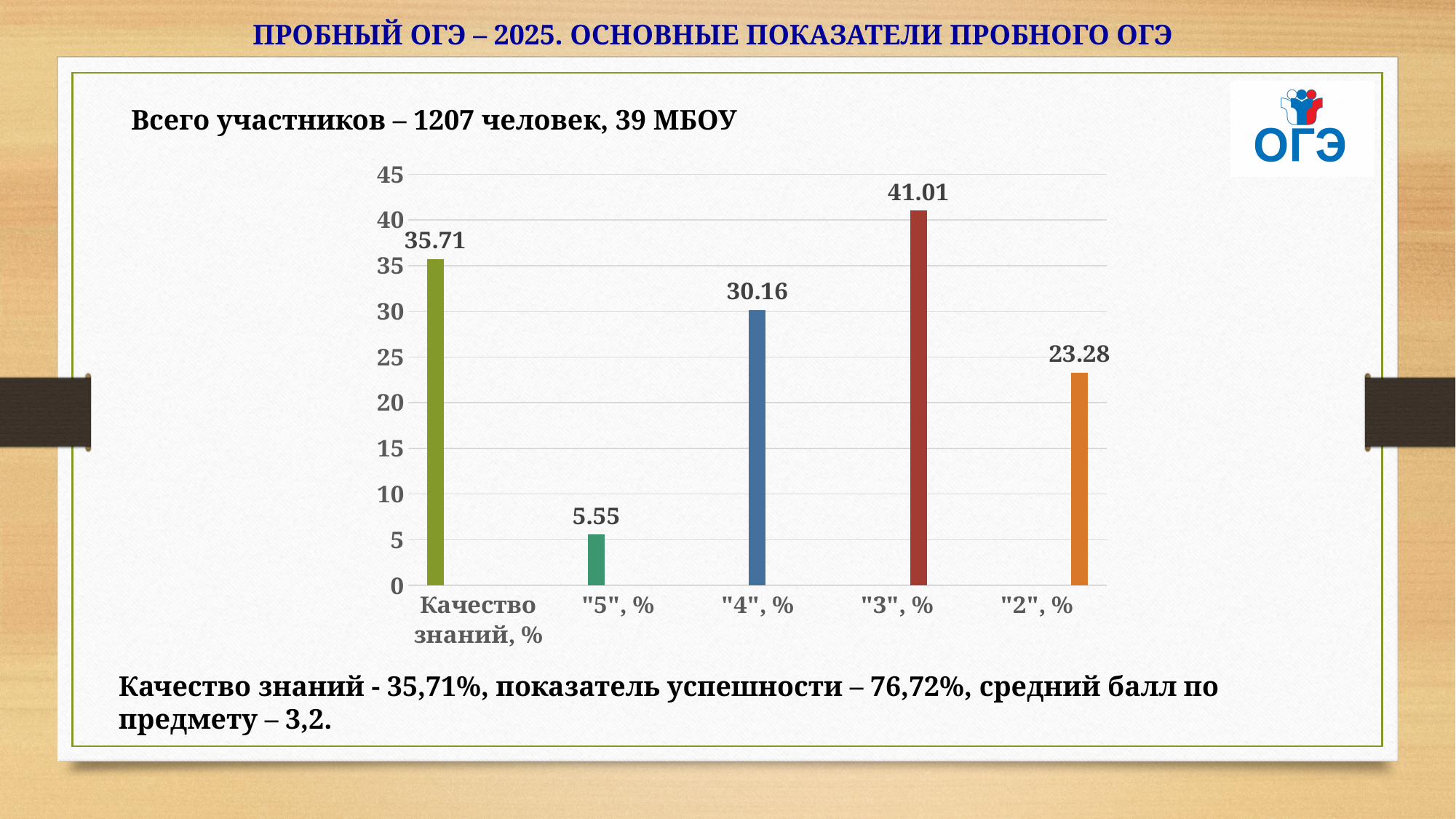
Which category has the highest bar? "3", % Which is larger, the value for "4", % or the value for "2", %? "4", % How many categories are shown on the x axis of the chart? 5 What is the value of the bar for "5", %? 5.55 Is the value for "4", % greater or less than 25? greater What is the value of the bar for "3", %? 41.01 What is the maximum value shown on the vertical axis of the chart? 45 What is the value of the bar for "2", %? 23.28 Which category has the lowest bar? "5", % What kind of chart is shown on the slide? bar chart What is the value of the bar for Качество знаний, %? 35.71 What is the difference between the values for "3", % and "4", %? 10.85